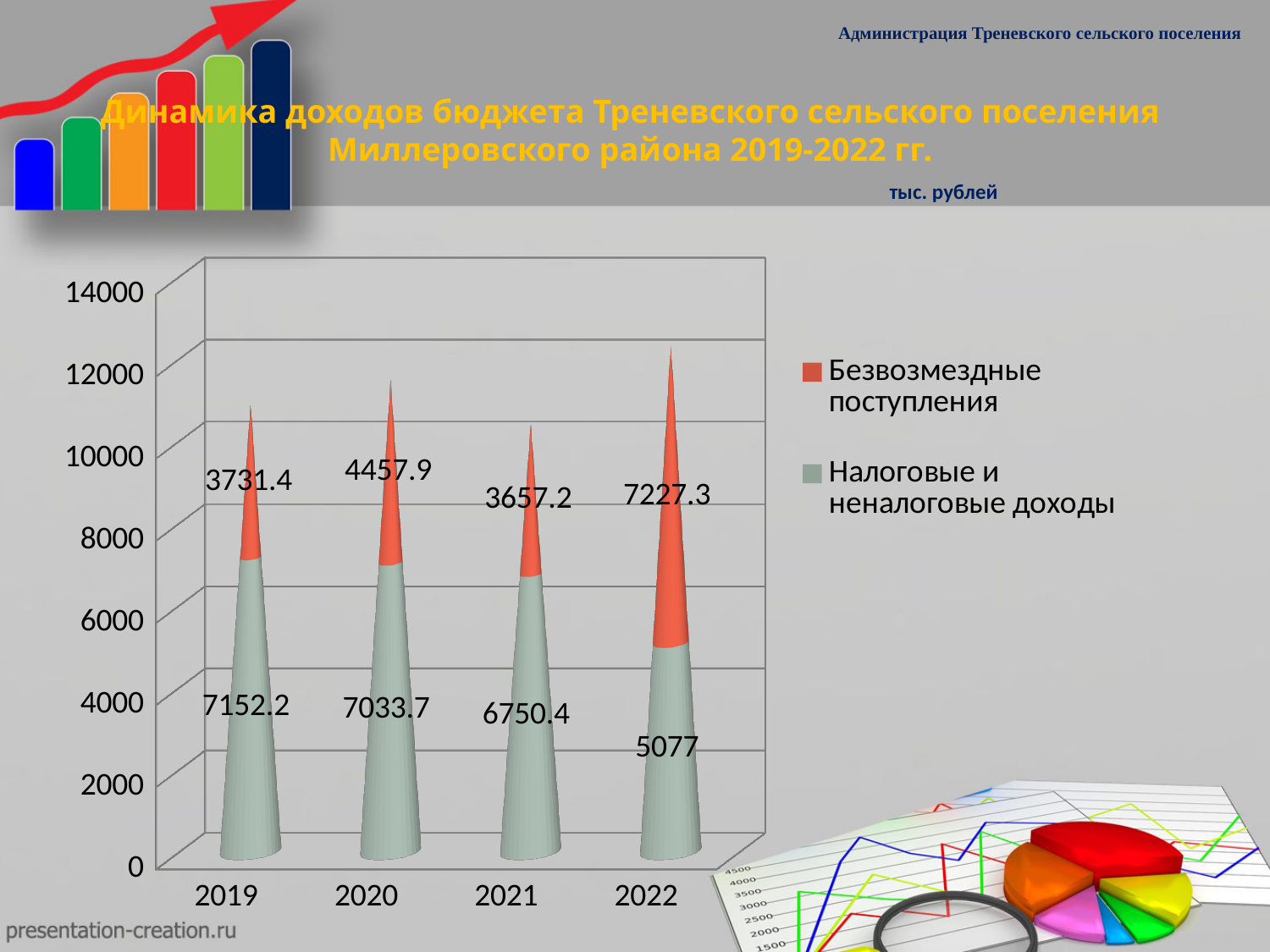
What is the value of Налоговые и неналоговые доходы for 2022? 5077 In which year is Налоговые и неналоговые доходы lowest? 2022 What is the value of Безвозмездные поступления for 2022? 7227.3 What is the difference between Налоговые и неналоговые доходы in 2019 and in 2021? 401.8 What kind of chart is shown on the slide? Stacked bar chart What is the value of Налоговые и неналоговые доходы for 2019? 7152.2 What is the total of the stacked bar for 2022? 12304.3 How many years are shown on the x axis? 4 In which year is Безвозмездные поступления highest? 2022 How many series does the legend list? 2 Which is larger in 2022: Безвозмездные поступления or Налоговые и неналоговые доходы? Безвозмездные поступления What is the value of Безвозмездные поступления for 2020? 4457.9